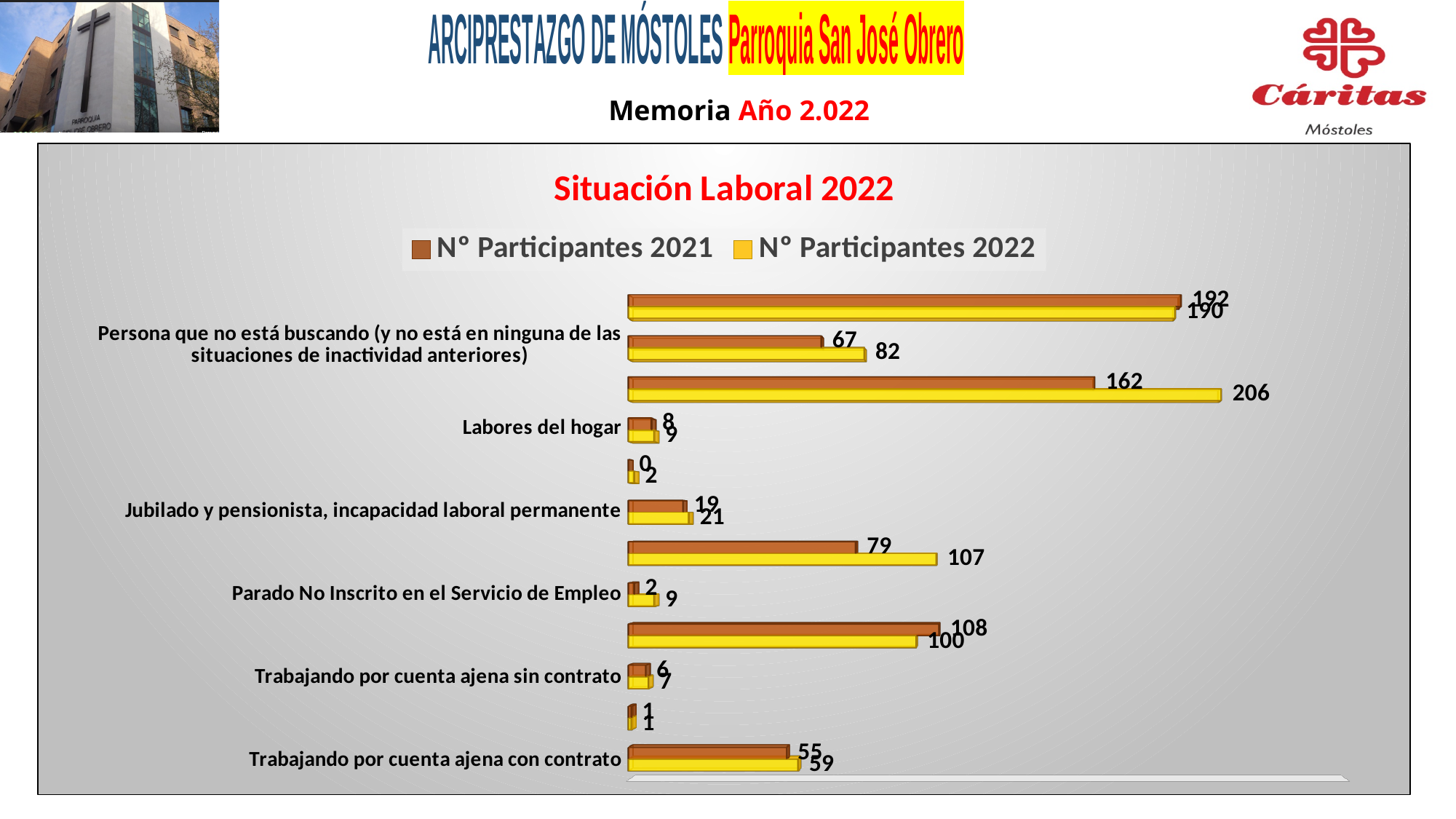
For 'Persona que no está buscando (y no está en ninguna de las situaciones de inactividad anteriores)', how much higher is Nº Participantes 2022 than Nº Participantes 2021? 15 What is the value of Nº Participantes 2021 for 'Labores del hogar'? 8 What is the value of Nº Participantes 2022 for 'Jubilado y pensionista, incapacidad laboral permanente'? 21 What is the value of Nº Participantes 2022 for 'Persona que no está buscando (y no está en ninguna de las situaciones de inactividad anteriores)'? 82 For 'Trabajando por cuenta ajena sin contrato', which series has the larger value, Nº Participantes 2021 or Nº Participantes 2022? Nº Participantes 2022 What is the value of Nº Participantes 2022 for 'Parado No Inscrito en el Servicio de Empleo'? 9 What is the highest value shown for the Nº Participantes 2022 series? 206 What is the value of Nº Participantes 2021 for 'Trabajando por cuenta ajena con contrato'? 55 How many series does the legend of the 'Situación Laboral 2022' chart list? 2 How many categories (pairs of bars) are plotted in the 'Situación Laboral 2022' chart? 12 What colour represents Nº Participantes 2022 in the chart? Yellow What kind of chart is shown under the title 'Situación Laboral 2022'? Bar chart